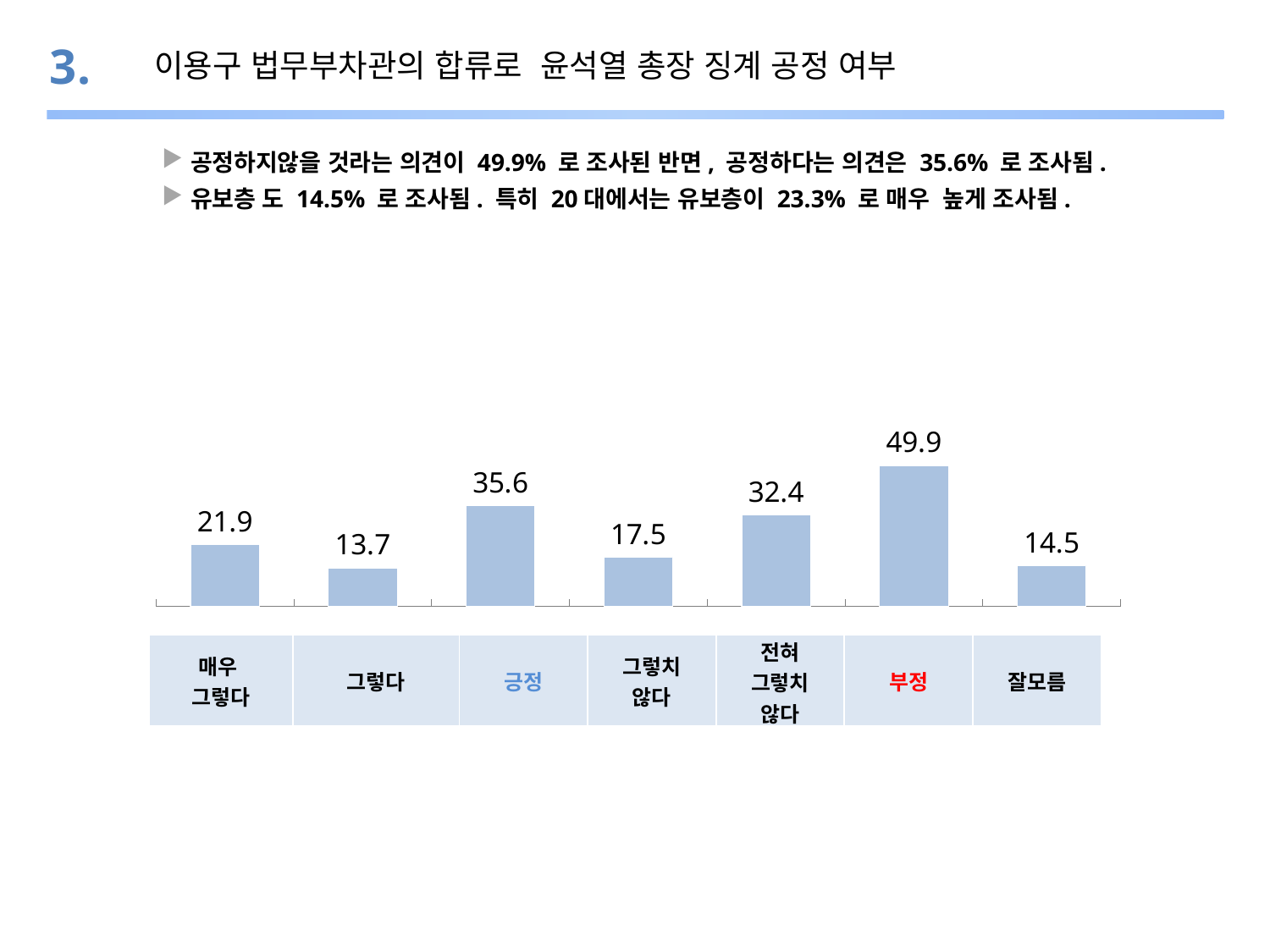
How many categories are shown in the chart? 7 What is the difference between the values for 부정 and 긍정? 14.3 Which category has the highest value? 부정 What is the value for 매우 그렇다? 21.9 What is the value for 잘모름? 14.5 What is the value for 긍정? 35.6 What is the value for 그렇다? 13.7 Which category has the lowest value? 그렇다 Which is larger, the value for 그렇치 않다 or the value for 매우 그렇다? 매우 그렇다 What is the value for 전혀 그렇치 않다? 32.4 What is the total of the values for 그렇치 않다 and 전혀 그렇치 않다? 49.9 What kind of chart is shown on the slide? bar chart